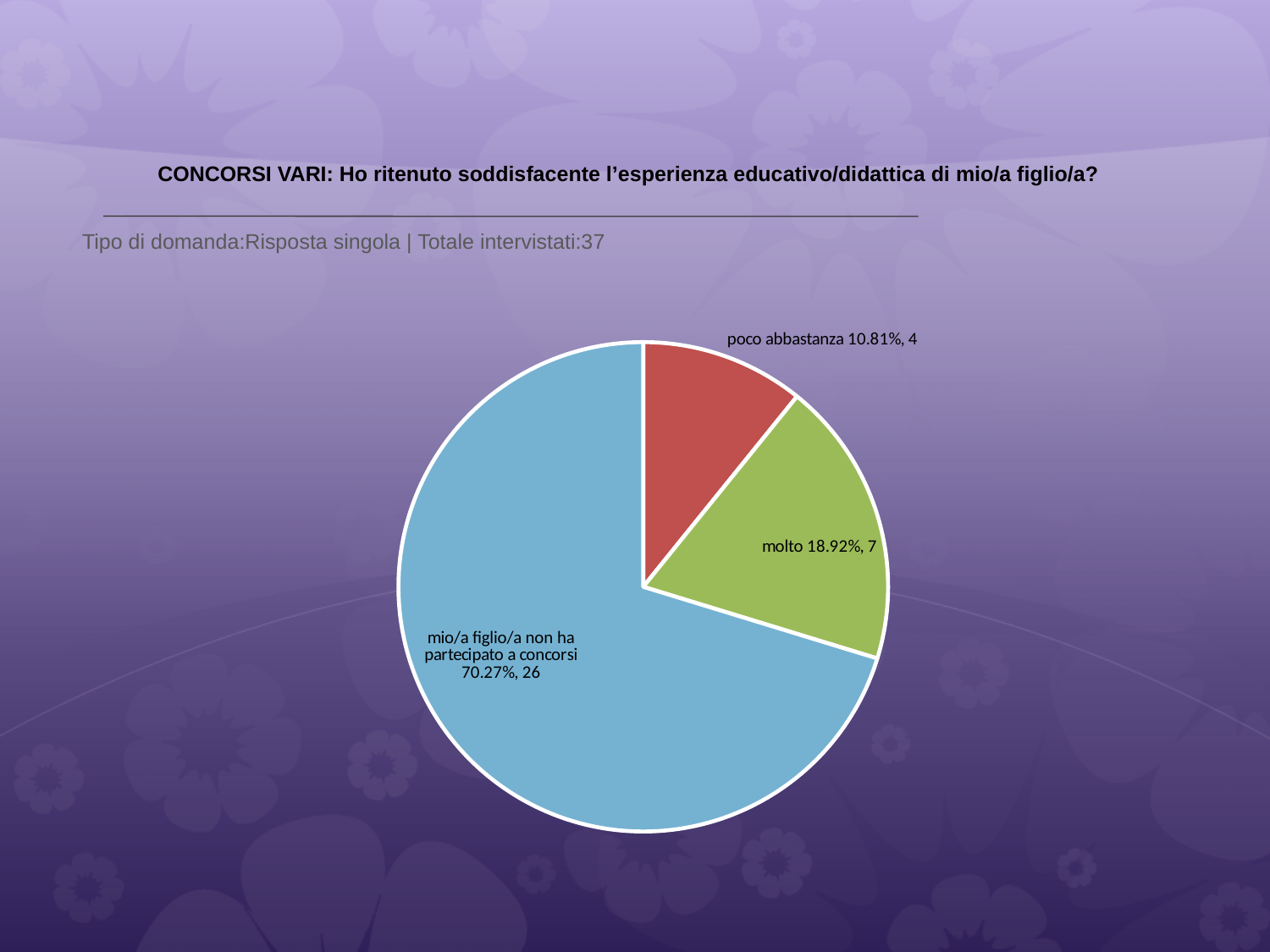
How many slices does the pie chart have? 3 What colour is the 'molto' slice? green What is the difference in respondent count between 'molto' and 'poco abbastanza'? 3 Which category has the largest slice? mio/a figlio/a non ha partecipato a concorsi What kind of chart is shown on the slide? pie chart Which category has the smallest slice? poco abbastanza How many respondents chose 'poco abbastanza'? 4 What percentage share does the 'molto' slice have? 18.92% What is the total number of respondents across all slices? 37 How many respondents chose 'mio/a figlio/a non ha partecipato a concorsi'? 26 Which has more respondents, 'molto' or 'poco abbastanza'? molto What percentage share does the 'poco abbastanza' slice have? 10.81%